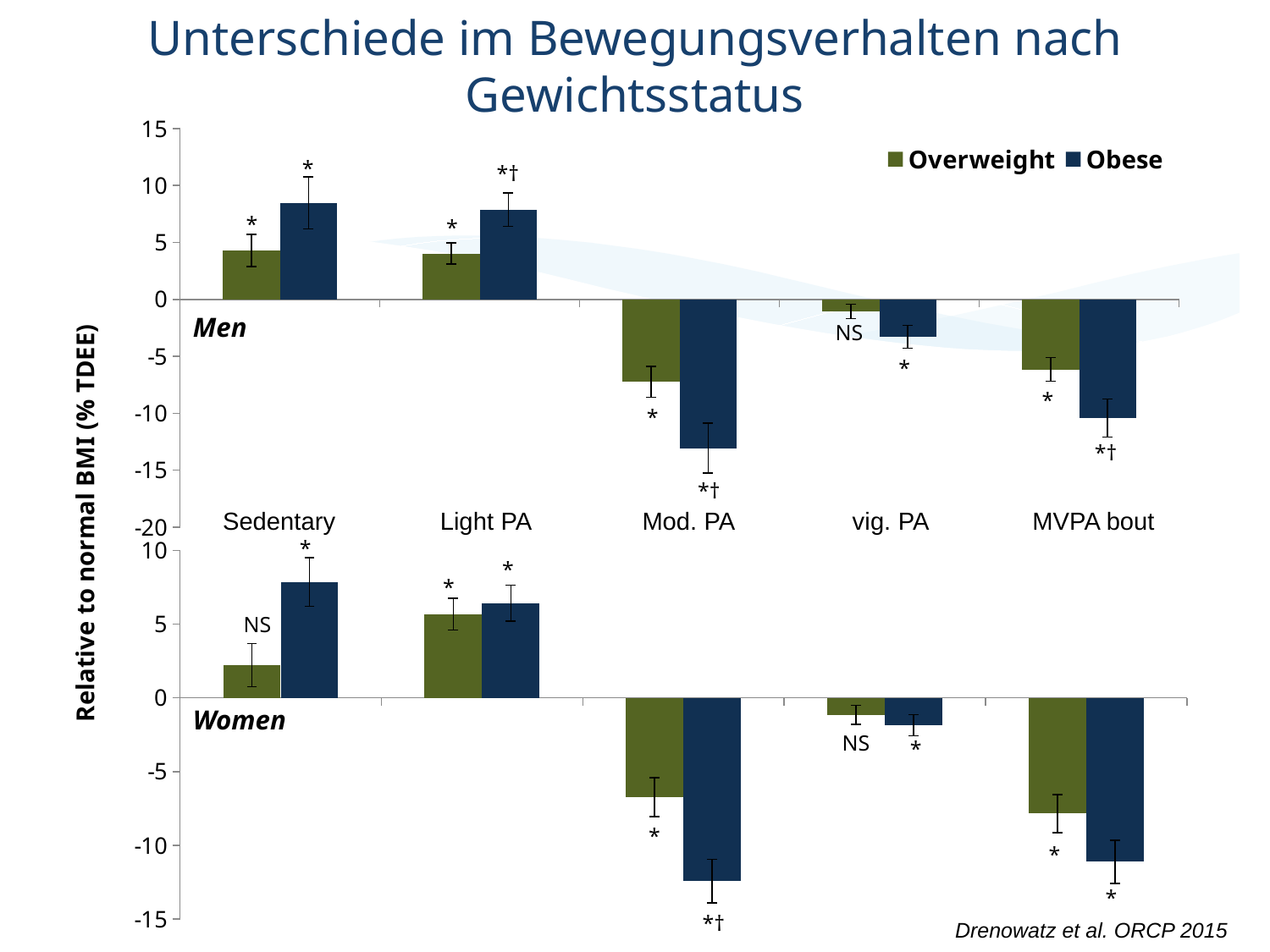
In the Men chart, which series has the larger value for Sedentary, Overweight or Obese? Obese What kind of chart is the Men chart at the top of the slide? bar chart In the Men chart, which category has the lowest Obese value? Mod. PA In the Women chart, is the Overweight value for Sedentary greater or less than 5? less What is the label of the shared y axis? Relative to normal BMI (% TDEE) In the Men chart, is the Obese value for Mod. PA greater or less than -10? less How many categories are shown on the x axis of the Women chart? 5 In the Men chart, is the Obese value for Sedentary greater or less than 5? greater How many series does the legend list? 2 Which two series are listed in the legend? Overweight and Obese In the Women chart, which series has the lower value for MVPA bout, Overweight or Obese? Obese